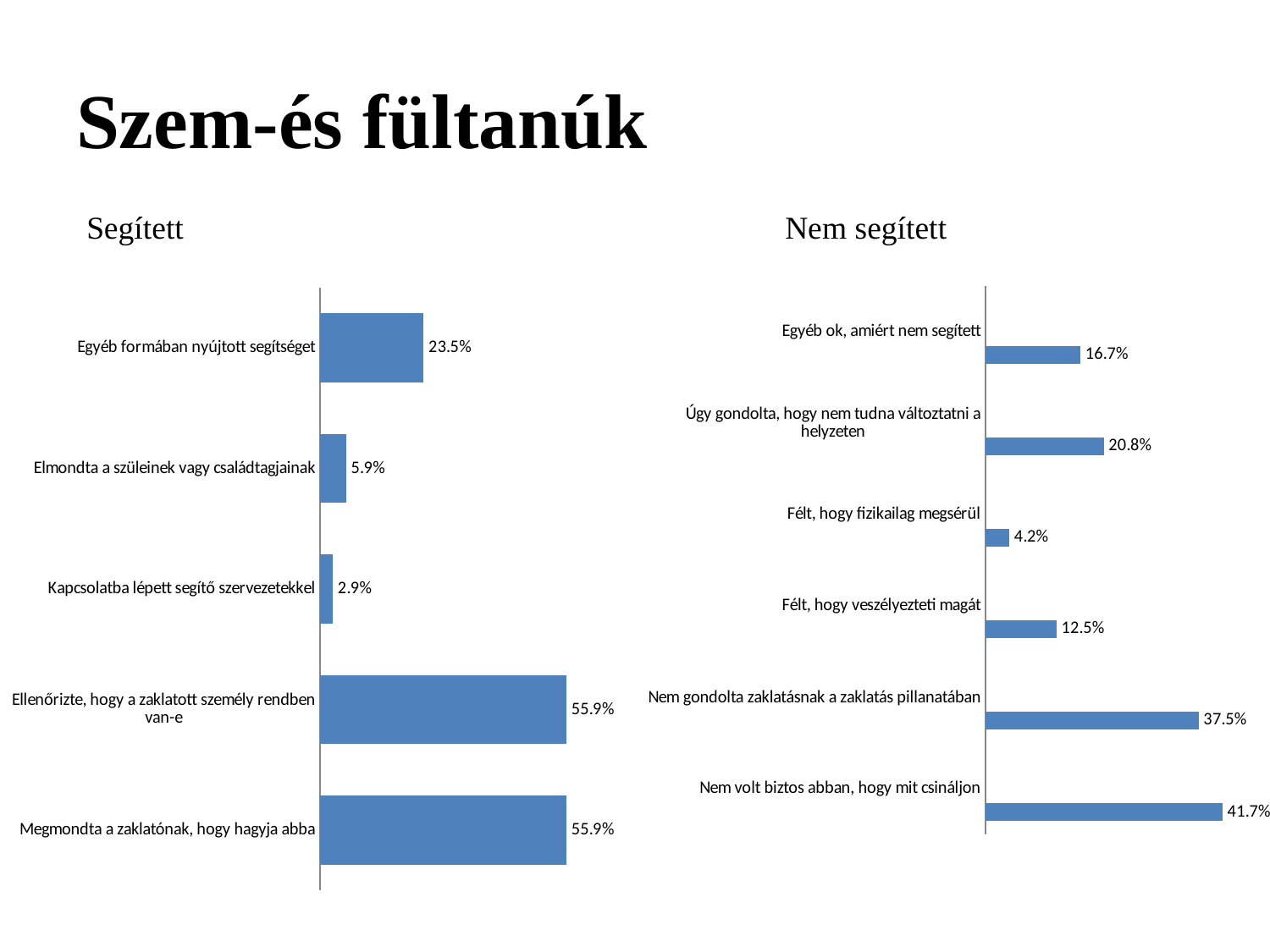
In the 'Nem segített' chart, which category has the lowest value? Félt, hogy fizikailag megsérül What type of chart is the 'Segített' chart? Bar chart In the 'Segített' chart, what is the value for 'Egyéb formában nyújtott segítséget'? 23.5% In the 'Nem segített' chart, which category has the highest value? Nem volt biztos abban, hogy mit csináljon In the 'Nem segített' chart, what is the value for 'Úgy gondolta, hogy nem tudna változtatni a helyzeten'? 20.8% In the 'Segített' chart, what is the difference between 'Egyéb formában nyújtott segítséget' and 'Elmondta a szüleinek vagy családtagjainak'? 17.6% In the 'Segített' chart, what is the value for 'Kapcsolatba lépett segítő szervezetekkel'? 2.9% In the 'Segített' chart, how many categories are shown? 5 In the 'Nem segített' chart, which is larger: 'Egyéb ok, amiért nem segített' or 'Félt, hogy veszélyezteti magát'? Egyéb ok, amiért nem segített In the 'Segített' chart, which category has the lowest value? Kapcsolatba lépett segítő szervezetekkel In the 'Nem segített' chart, how many categories are shown? 6 In the 'Nem segített' chart, what is the difference between 'Nem volt biztos abban, hogy mit csináljon' and 'Nem gondolta zaklatásnak a zaklatás pillanatában'? 4.2%